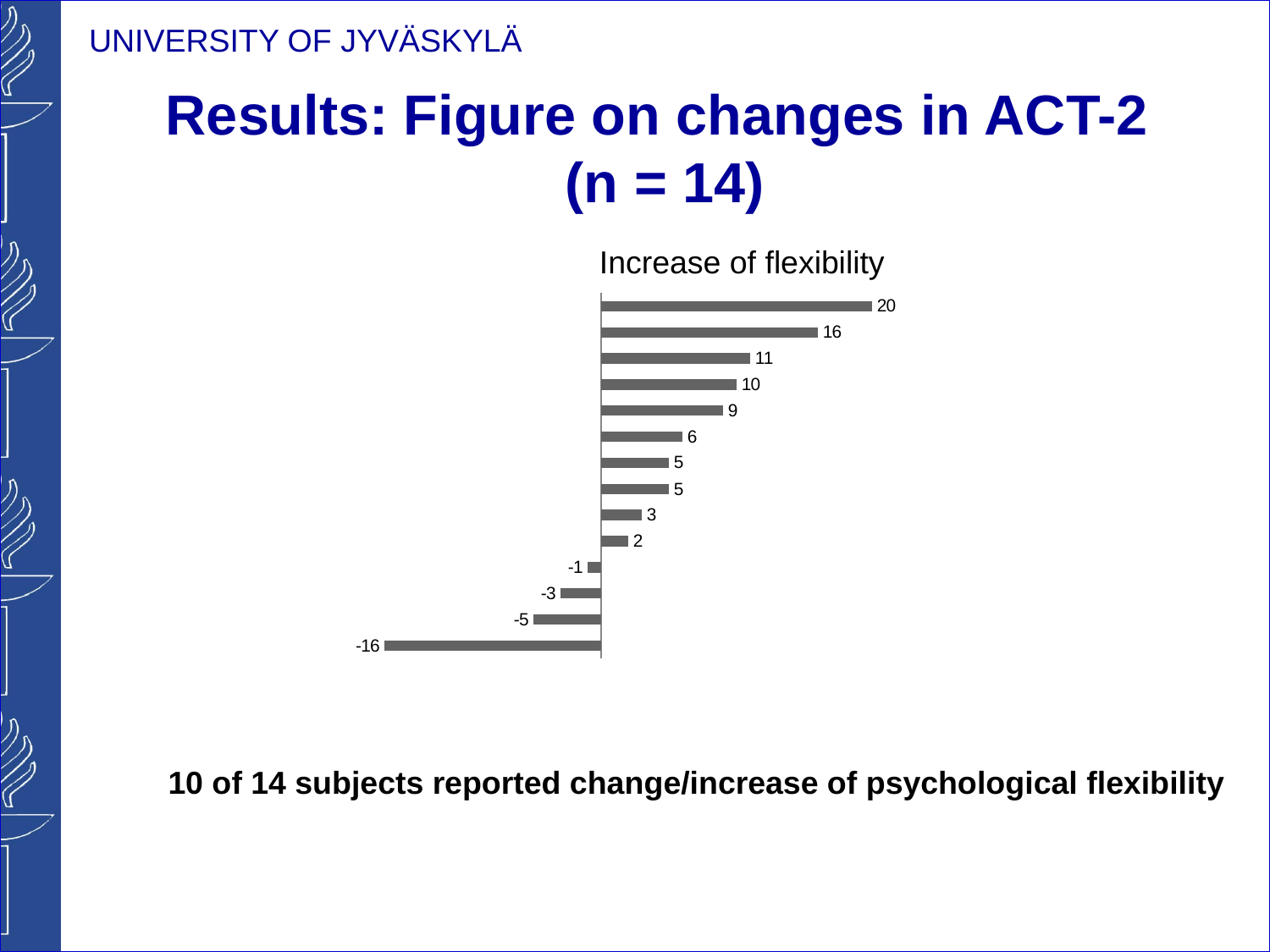
What is the value of the bottommost bar in the chart? -16 What is the title of the chart? Increase of flexibility Do the bar values increase or decrease going from the top of the chart to the bottom? decrease What kind of chart is shown on the slide? bar chart How many bars are plotted in the chart? 14 How many bars in the chart have negative values? 4 What is the difference between the largest value (20) and the second largest value (16)? 4 What is the value of the second bar from the top? 16 What is the value of the topmost bar in the chart? 20 What is the largest value shown in the chart? 20 How many bars in the chart have positive values? 10 What is the smallest value shown in the chart? -16